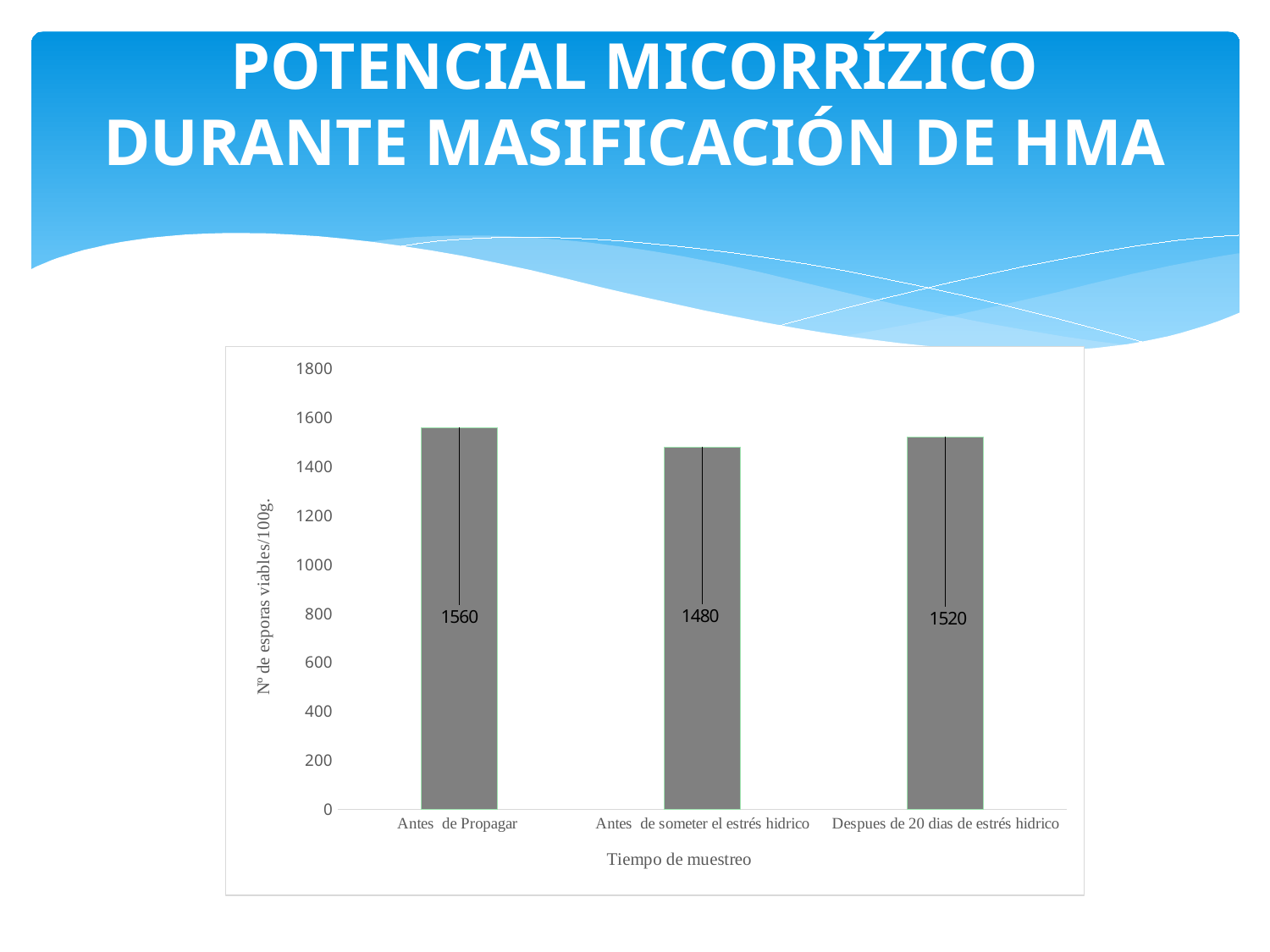
What is the value for "Antes de Propagar"? 1560 What is the value for "Antes de someter el estrés hidrico"? 1480 Which is larger, the value for "Antes de Propagar" or the value for "Despues de 20 dias de estrés hidrico"? Antes de Propagar What is the value for "Despues de 20 dias de estrés hidrico"? 1520 How many categories are shown on the x axis? 3 Which category has the highest value? Antes de Propagar What kind of chart is shown on the slide? bar chart What is the difference between the values for "Antes de Propagar" and "Antes de someter el estrés hidrico"? 80 Is the value for "Antes de someter el estrés hidrico" greater or less than 1600? less What is the difference between the values for "Despues de 20 dias de estrés hidrico" and "Antes de someter el estrés hidrico"? 40 What is the label of the x axis? Tiempo de muestreo Which category has the lowest value? Antes de someter el estrés hidrico